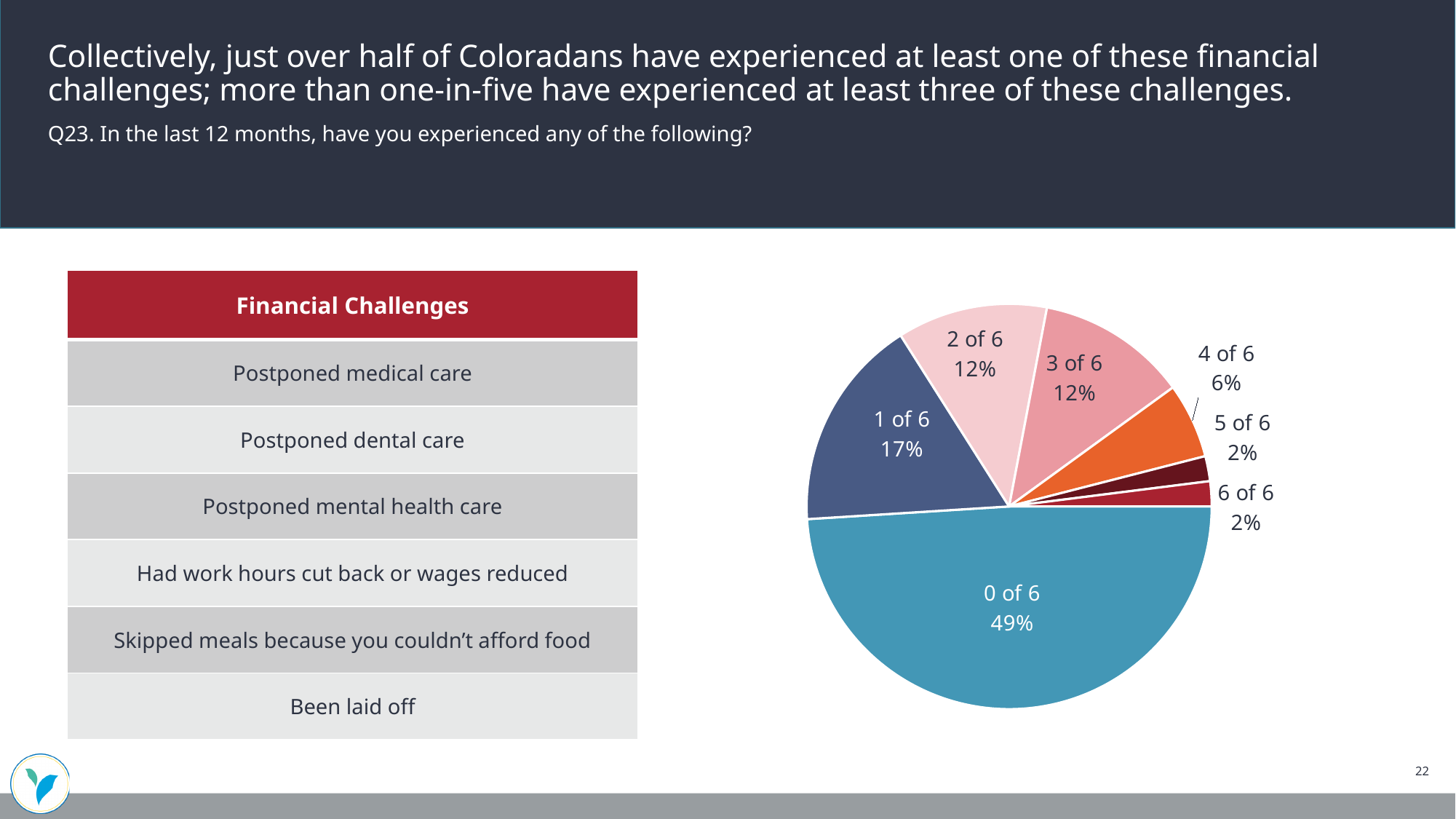
How many financial challenges are listed in the table to the left of the pie chart? 6 Which slice of the pie chart is the largest? 0 of 6 How many slices does the pie chart have? 7 What kind of chart is shown on the slide? pie chart What share of the pie is labelled "1 of 6"? 17% What share of the pie is labelled "2 of 6"? 12% What share of the pie is labelled "4 of 6"? 6% Which slice is larger, "1 of 6" or "4 of 6"? 1 of 6 What is the combined share of the "3 of 6", "4 of 6", "5 of 6" and "6 of 6" slices? 22% What share of the pie is labelled "0 of 6"? 49% What share of the pie is labelled "6 of 6"? 2% What is the difference in percentage points between the "0 of 6" slice and the "1 of 6" slice? 32